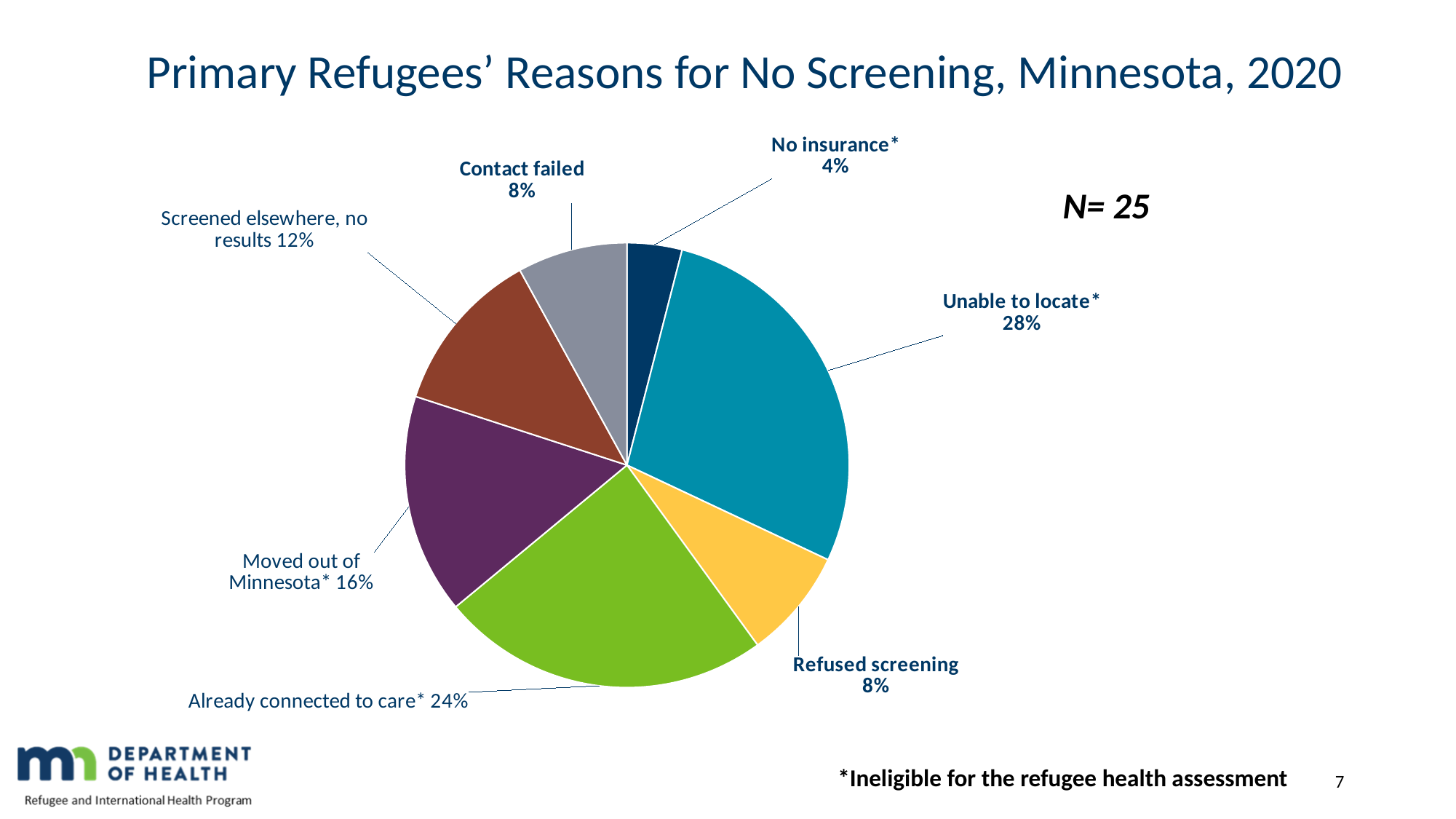
What percentage is shown for 'Moved out of Minnesota'? 16% What is the difference in percentage points between 'Unable to locate' and 'Already connected to care'? 4 Which reason has the largest share of the pie? Unable to locate What is the N value shown on the slide? N= 25 What is the title of the chart? Primary Refugees' Reasons for No Screening, Minnesota, 2020 What percentage is shown for 'Screened elsewhere, no results'? 12% What type of chart is shown on the slide? Pie chart How many slices does the pie chart have? 7 What share of the pie is 'Already connected to care'? 24% Which reason has the smallest share of the pie? No insurance What percentage of primary refugees were not screened because they were unable to be located? 28% Which is larger, the share for 'Moved out of Minnesota' or the share for 'Screened elsewhere, no results'? Moved out of Minnesota